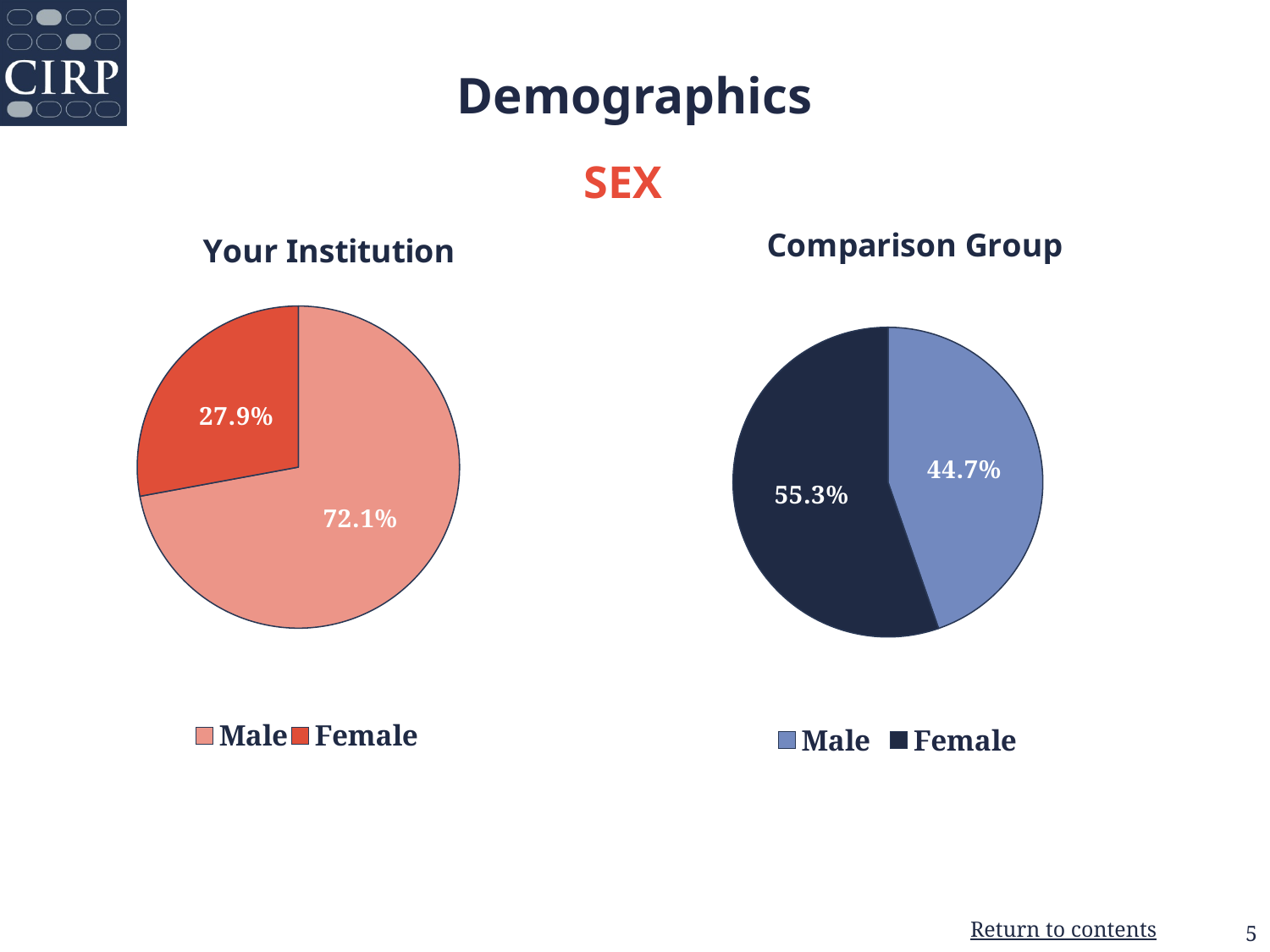
In the 'Comparison Group' chart, what percentage is Female? 55.3% How many categories does the 'Your Institution' chart show? 2 In the 'Comparison Group' chart, what percentage is Male? 44.7% In the 'Your Institution' chart, what percentage is Female? 27.9% What type of chart is the 'Comparison Group' chart? Pie chart In the 'Your Institution' chart, what is the difference between the Male and Female shares? 44.2% In the 'Comparison Group' chart, which category has the smallest share? Male Is the Male share larger in the 'Your Institution' chart or the 'Comparison Group' chart? Your Institution In the 'Your Institution' chart, which category has the largest share? Male What are the legend entries in the 'Comparison Group' chart? Male, Female In the 'Your Institution' chart, what percentage is Male? 72.1% In the 'Comparison Group' chart, what is the difference between the Female and Male shares? 10.6%